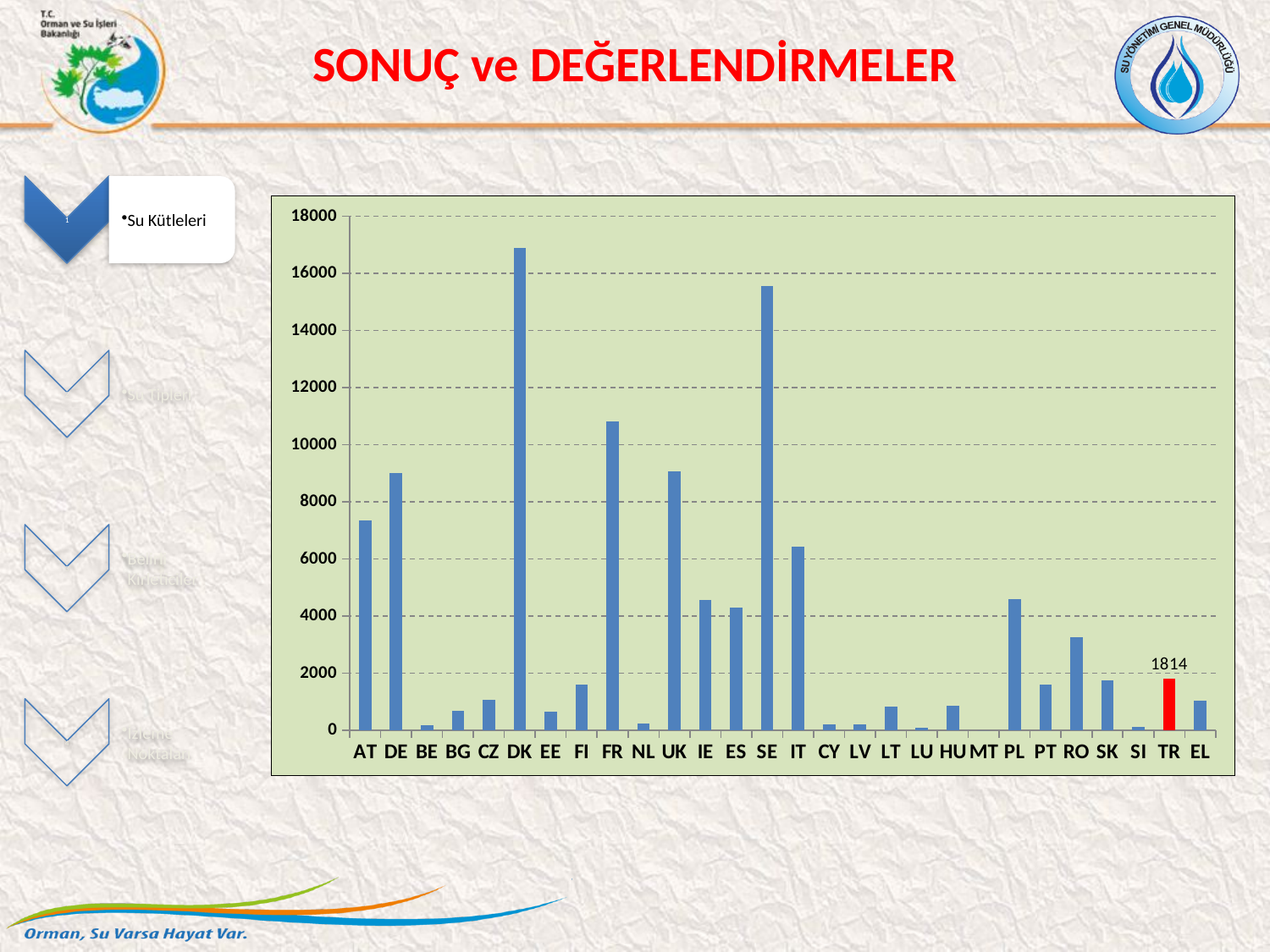
Which has the larger value, AT or DE? DE Which has the larger value, DK or SE? DK Which country has the highest bar in the chart? DK What is the value shown for TR in the chart? 1814 Is the value for FR greater or less than 10000? greater Which country's bar is coloured red instead of blue in the chart? TR Is the value for SE greater or less than 16000? less What type of chart is shown on the slide? bar chart How many countries (categories) are shown on the x axis of the chart? 28 Is the value for PL greater or less than 4000? greater